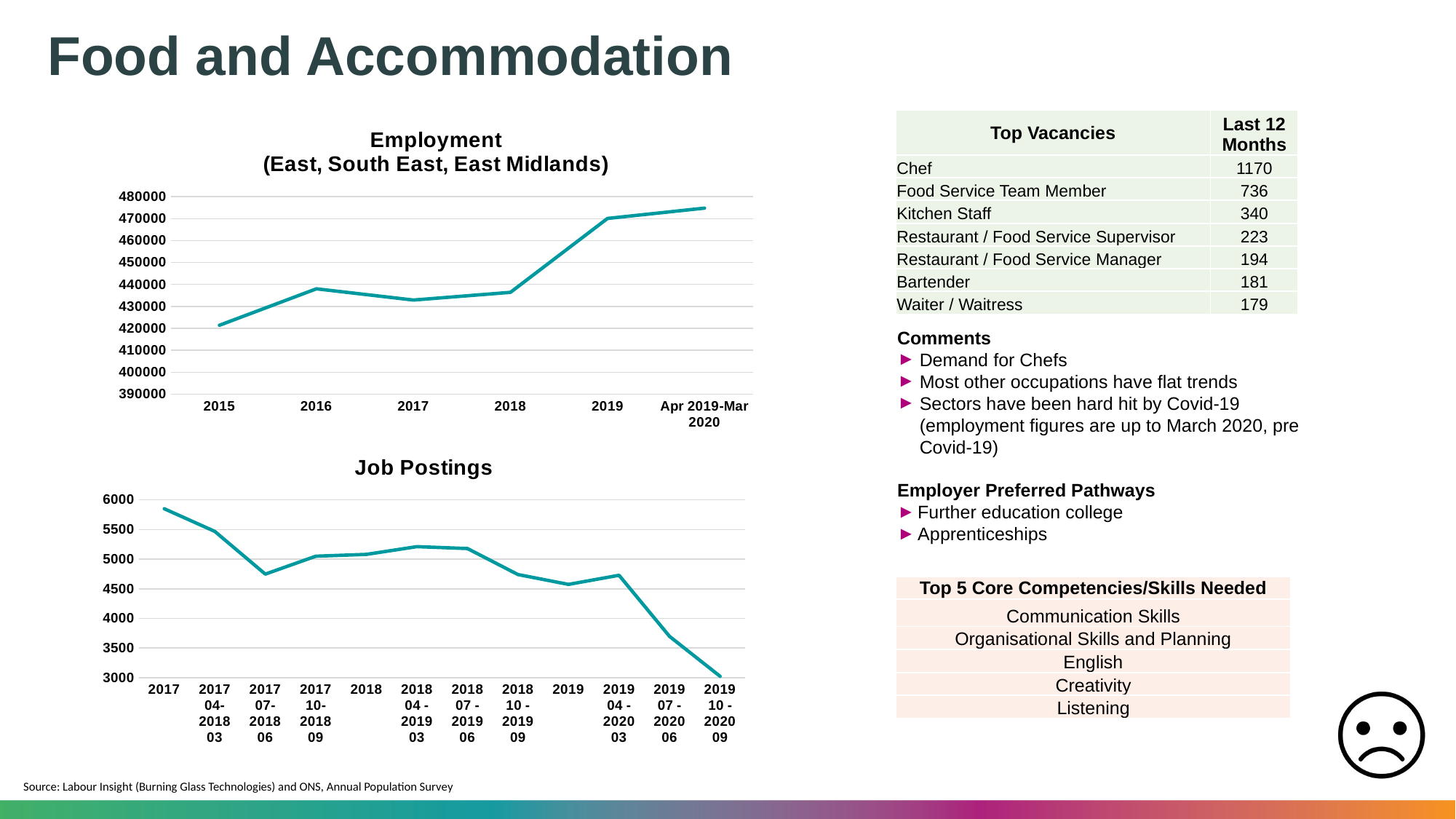
How many data points are plotted on the Employment (East, South East, East Midlands) chart? 6 On the Job Postings chart, which period has the lowest number of job postings? 2019 10 - 2020 09 On the Employment (East, South East, East Midlands) chart, is the value for 2019 greater or less than 460000? greater On the Employment (East, South East, East Midlands) chart, which is larger, the value for 2018 or the value for 2019? 2019 On the Employment (East, South East, East Midlands) chart, is the value for 2015 greater or less than 430000? less What kind of chart is the Employment (East, South East, East Midlands) chart? line chart On the Employment (East, South East, East Midlands) chart, which period has the highest employment? Apr 2019-Mar 2020 How many data points are plotted on the Job Postings chart? 12 On the Job Postings chart, is the value for 2019 07 - 2020 06 greater or less than 4000? less On the Employment (East, South East, East Midlands) chart, does employment overall rise or fall from 2015 to Apr 2019-Mar 2020? rise On the Job Postings chart, which period has the highest number of job postings? 2017 On the Employment (East, South East, East Midlands) chart, which year has the lowest employment? 2015